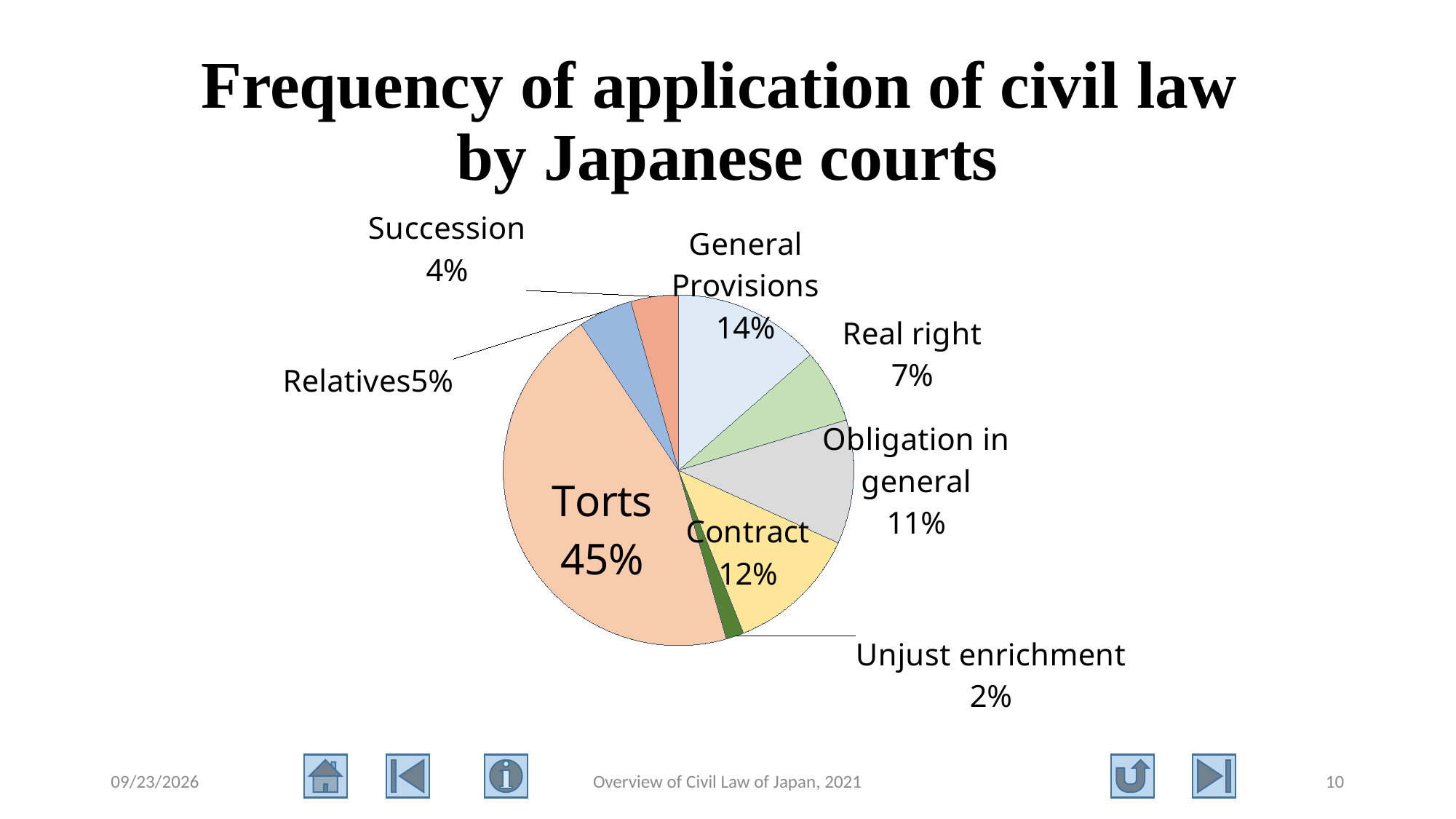
What is the value shown for General Provisions? 14% What share of the pie does Torts account for? 45% What is the difference between the shares for Contract and Real right? 5% How many slices does the pie chart have? 8 What is the value shown for Obligation in general? 11% Which category has the smallest slice of the pie? Unjust enrichment Which is larger, the share for Relatives or the share for Succession? Relatives What is the title of the slide containing the chart? Frequency of application of civil law by Japanese courts What kind of chart is shown on the slide? pie chart What is the value shown for Unjust enrichment? 2% Which category has the largest slice of the pie? Torts What is the difference between the shares for Torts and General Provisions? 31%